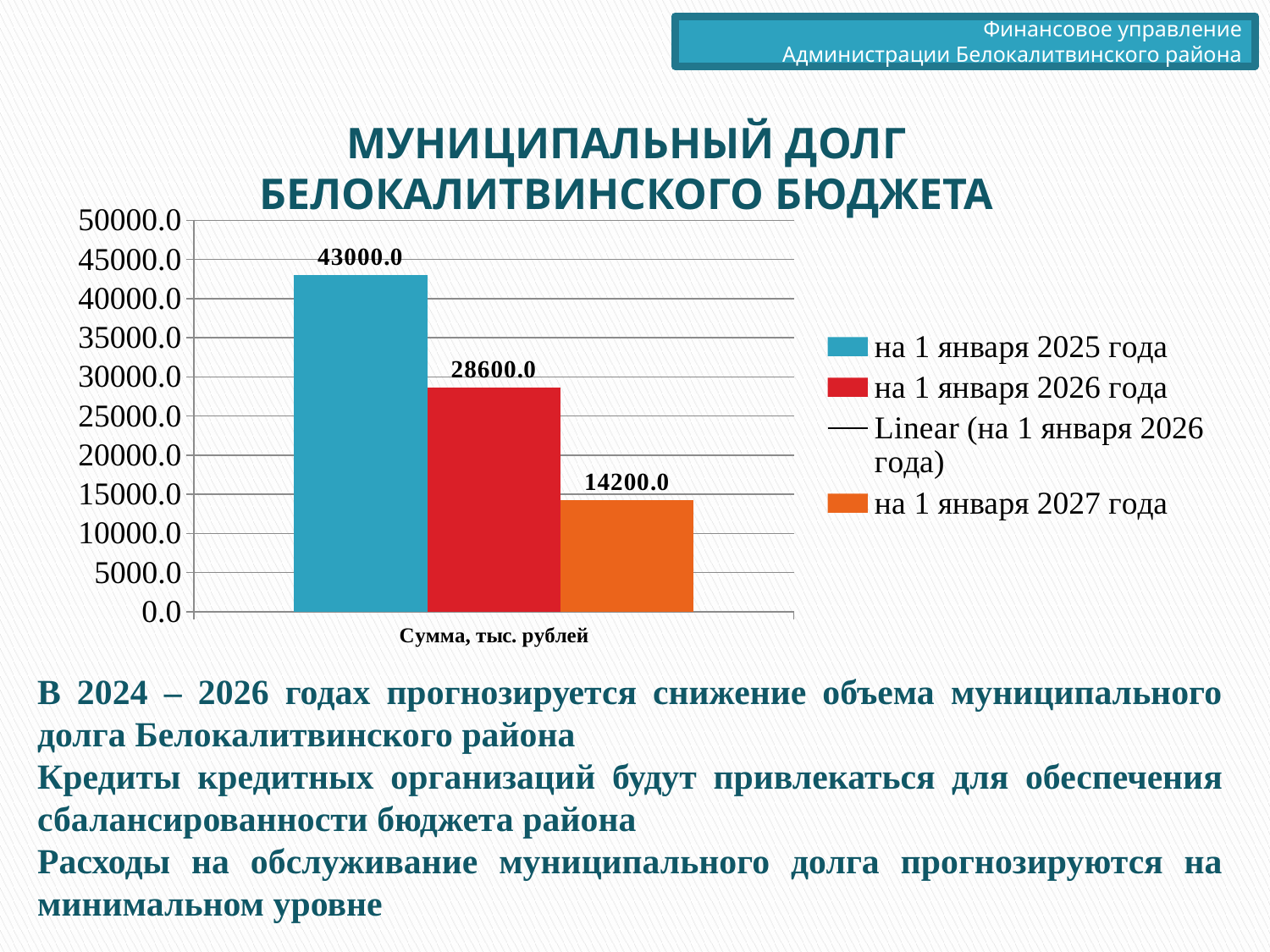
What is the label shown under the bars on the x axis? Сумма, тыс. рублей Which series has the lowest value? на 1 января 2027 года What is the value for 'на 1 января 2026 года'? 28600.0 What is the difference between the values for 'на 1 января 2026 года' and 'на 1 января 2027 года'? 14400.0 Which is larger, the value for 'на 1 января 2026 года' or 'на 1 января 2027 года'? на 1 января 2026 года What is the value for 'на 1 января 2025 года'? 43000.0 What is the value for 'на 1 января 2027 года'? 14200.0 What kind of chart is shown on the slide? bar chart Is the value for 'на 1 января 2026 года' greater or less than 30000.0? less What is the difference between the values for 'на 1 января 2025 года' and 'на 1 января 2026 года'? 14400.0 Which series has the highest value? на 1 января 2025 года How many entries does the legend list? 4